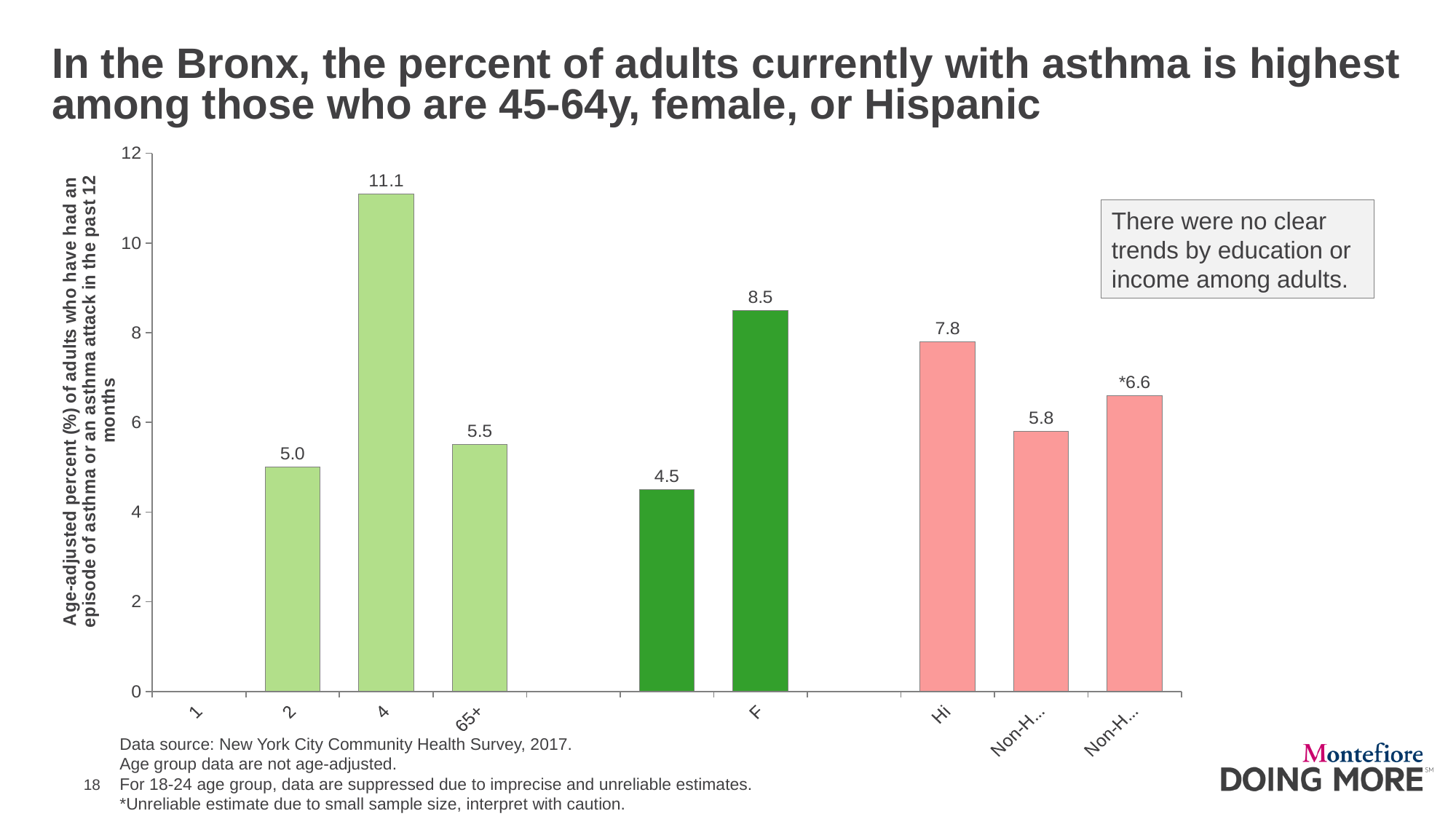
What is the difference between the value for Hi and the value for 65+? 2.3 What kind of chart is shown on the slide? bar chart What is the value for the category labelled Hi? 7.8 What is the value for the 65+ category? 5.5 What is the difference between the value for F and the value for 65+? 3.0 Which has a larger value, F or Hi? F What is the value of the tallest bar in the chart? 11.1 Which bar's data label is marked with an asterisk? The rightmost bar, labelled *6.6 What year is the New York City Community Health Survey data from, according to the data source note? 2017 How many bars are plotted in the chart? 8 What is the value of the shortest bar in the chart? 4.5 What is the value for the category labelled F? 8.5